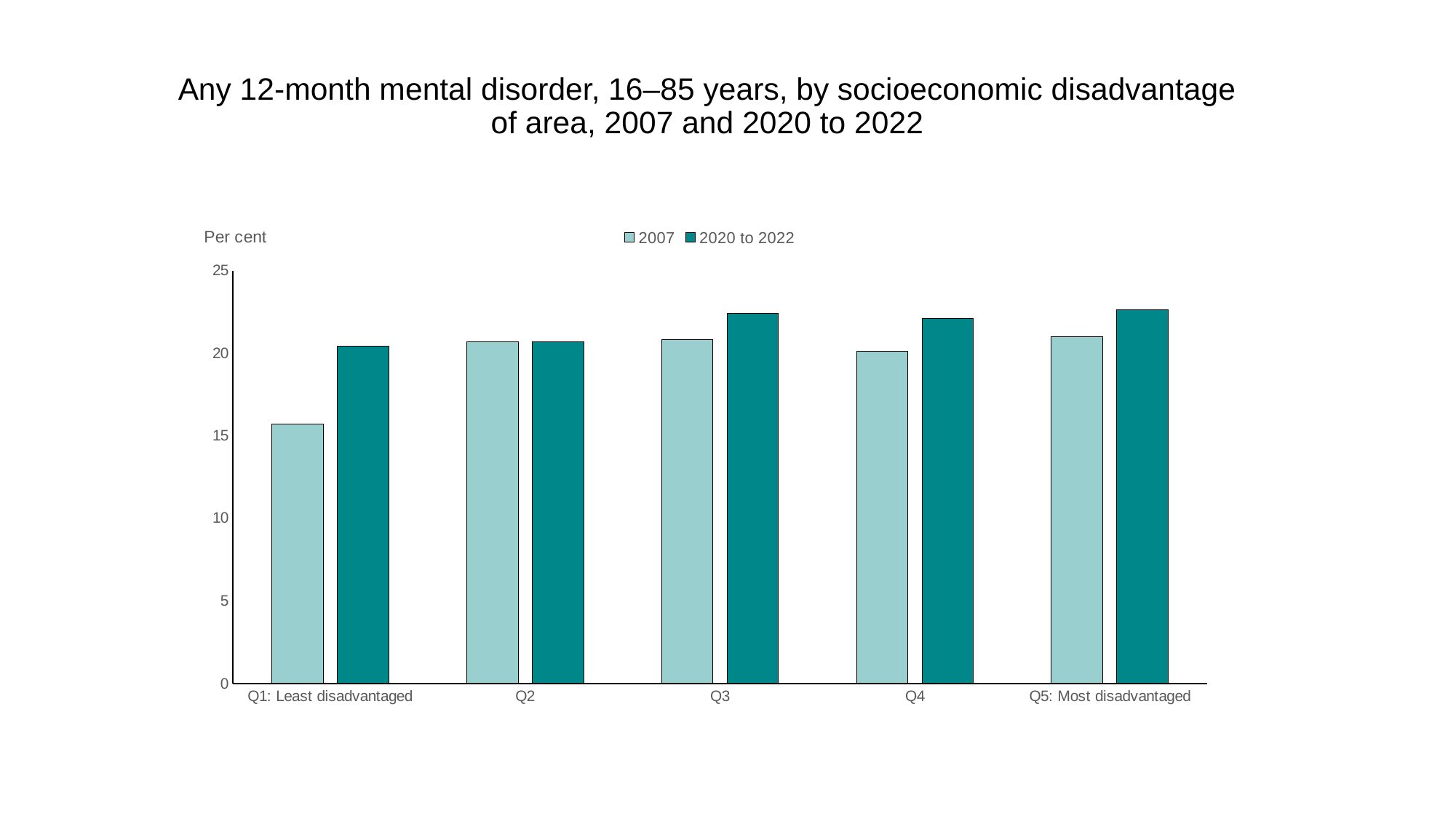
What are the two series named in the legend? 2007 and 2020 to 2022 Is the 2020 to 2022 value for Q1: Least disadvantaged greater or less than 20? greater For Q4, which series has the larger value, 2007 or 2020 to 2022? 2020 to 2022 What kind of chart is shown on the slide? bar chart How many socioeconomic disadvantage categories are shown on the x axis? 5 Is the 2007 value for Q1: Least disadvantaged greater or less than 20? less Is the 2020 to 2022 value for Q3 greater or less than 20? greater How many series does the legend list? 2 What is the label on the y axis? Per cent Which category has the lowest value for the 2007 series? Q1: Least disadvantaged For Q1: Least disadvantaged, which series has the larger value, 2007 or 2020 to 2022? 2020 to 2022